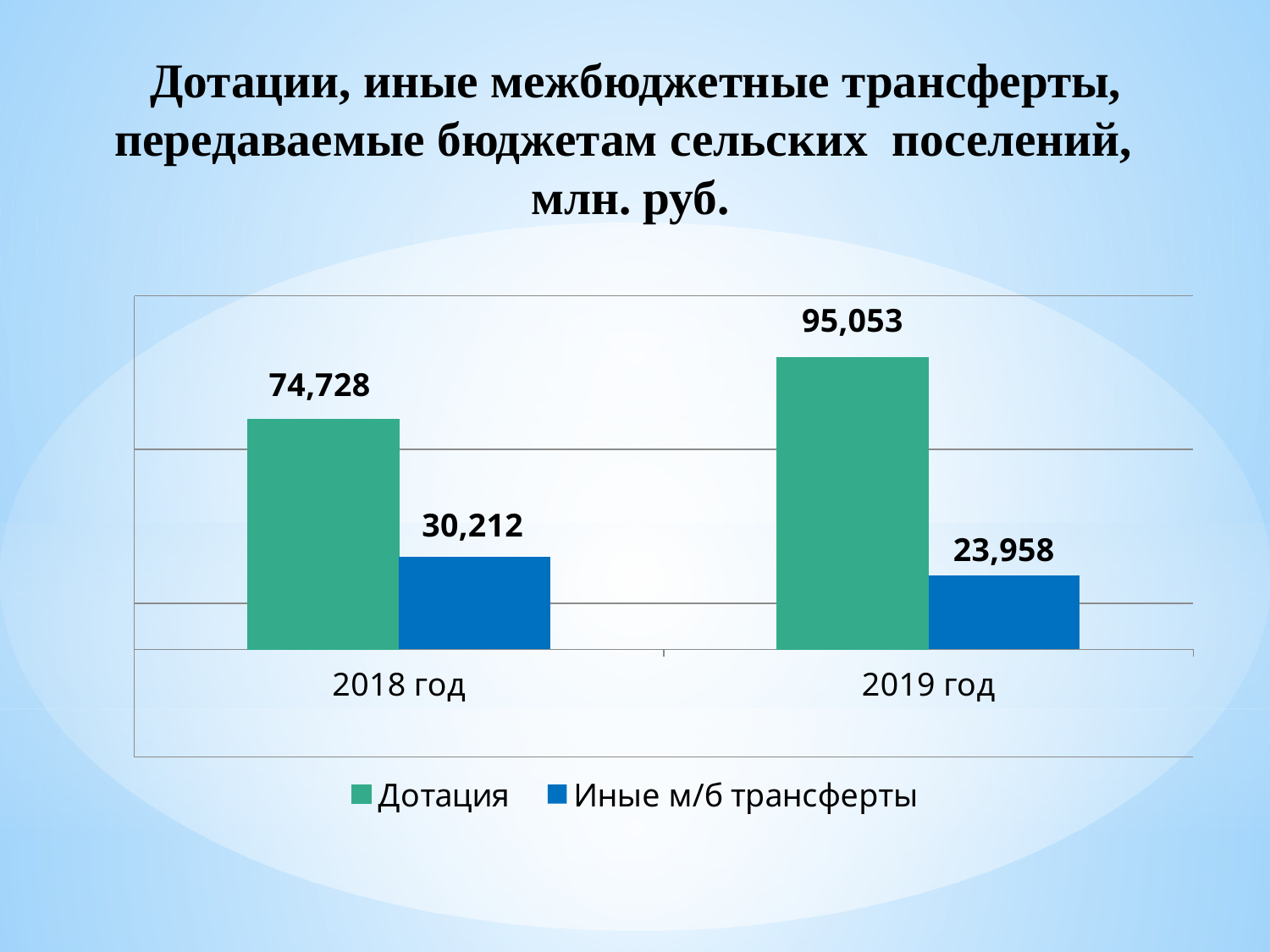
What kind of chart is shown on the slide? Bar chart What is the value of Дотация for 2019 год? 95,053 In which year is Дотация highest? 2019 год Does Иные м/б трансферты rise or fall from 2018 год to 2019 год? Fall What is the value of Дотация for 2018 год? 74,728 How many series does the legend list? 2 By how much did Дотация increase from 2018 год to 2019 год? 20,325 What is the value of Иные м/б трансферты for 2019 год? 23,958 What is the difference between Иные м/б трансферты in 2018 год and 2019 год? 6,254 What is the value of Иные м/б трансферты for 2018 год? 30,212 Which is larger in 2019 год: Дотация or Иные м/б трансферты? Дотация In which year is Иные м/б трансферты lowest? 2019 год